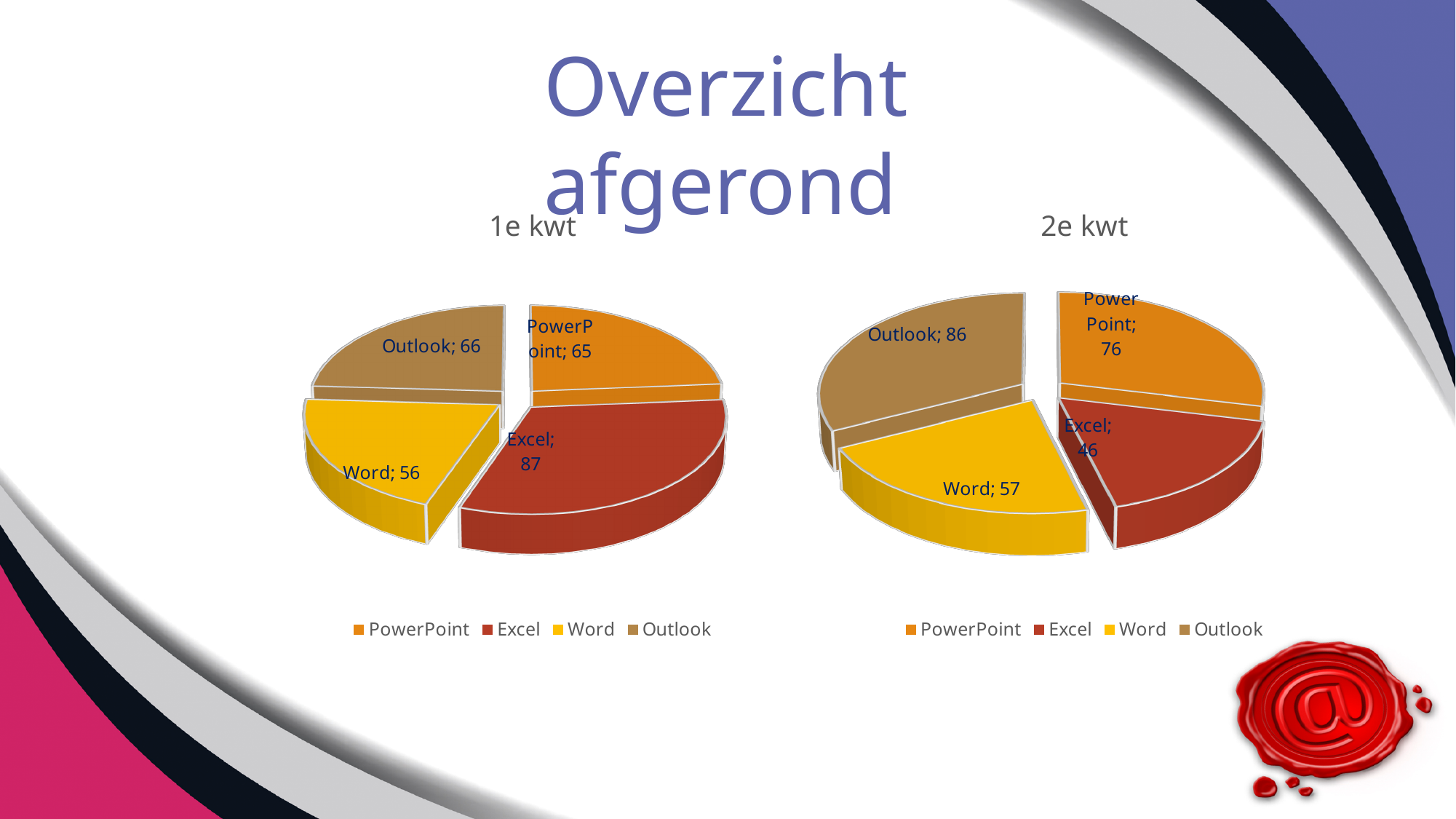
How many categories does the '1e kwt' pie chart show? 4 In the '2e kwt' pie chart, what is the value for Outlook? 86 In the '1e kwt' pie chart, what is the value for Excel? 87 In the '1e kwt' pie chart, which category has the smallest slice? Word In the '1e kwt' pie chart, which category has the largest slice? Excel In the '2e kwt' pie chart, which is larger: Outlook or PowerPoint? Outlook What is the total of all slices in the '2e kwt' pie chart? 265 What type of chart is used for '2e kwt'? Pie chart In the '2e kwt' pie chart, what is the value for PowerPoint? 76 In the '2e kwt' pie chart, which category has the smallest slice? Excel What is the difference between the Excel values in the '1e kwt' and '2e kwt' pie charts? 41 In the '1e kwt' pie chart, what is the value for Word? 56